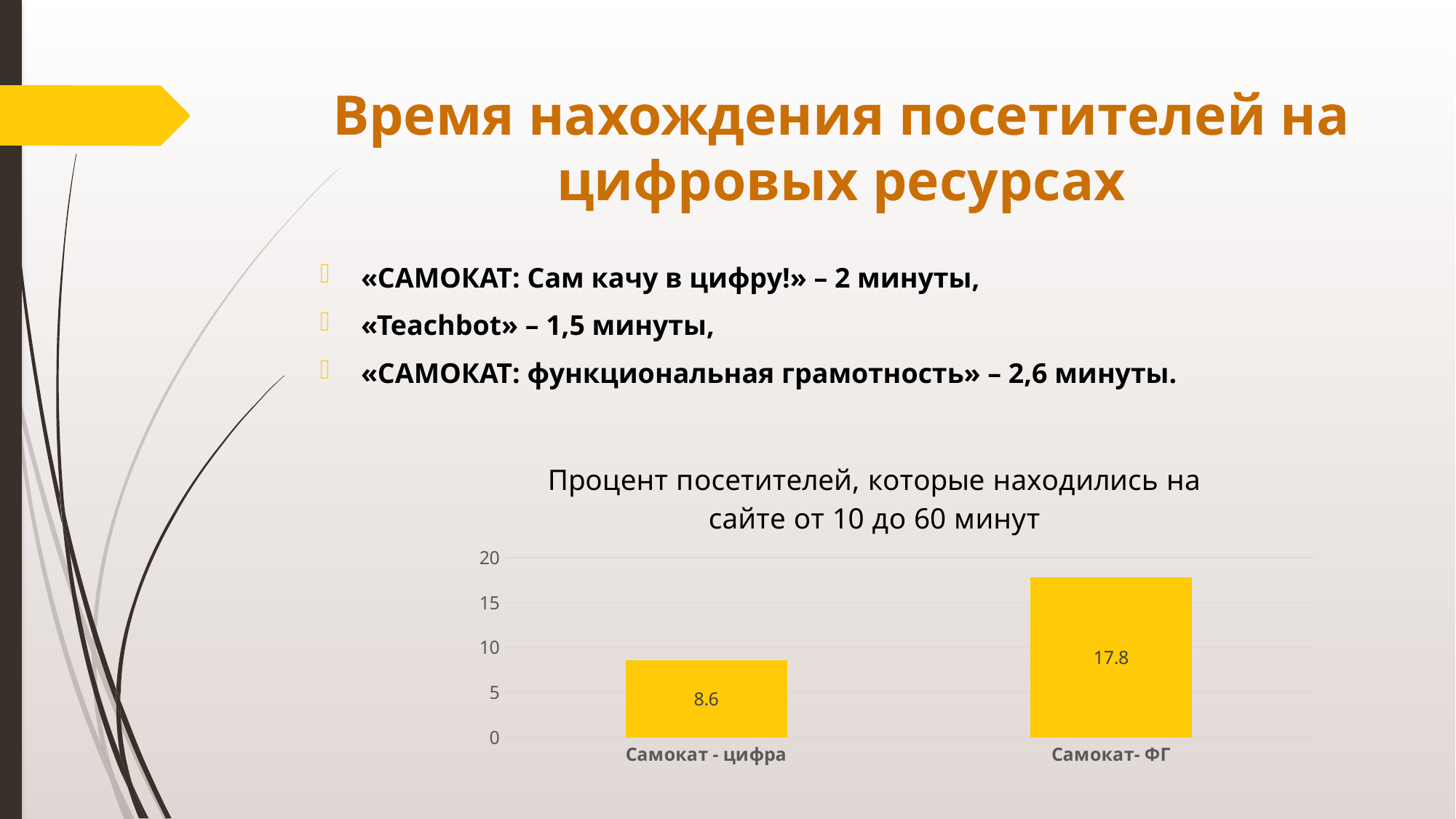
Which is larger, the value for Самокат - цифра or the value for Самокат- ФГ? Самокат- ФГ What is the difference between the values for Самокат- ФГ and Самокат - цифра? 9.2 What is the title of the chart? Процент посетителей, которые находились на сайте от 10 до 60 минут Is the value for Самокат- ФГ greater or less than 15? greater Which category has the highest value? Самокат- ФГ How many categories are shown in the chart? 2 What is the value for Самокат- ФГ? 17.8 Which category has the lowest value? Самокат - цифра Is the value for Самокат - цифра greater or less than 10? less What kind of chart is shown on the slide? bar chart What is the highest value shown on the vertical axis of the chart? 20 What is the value for Самокат - цифра? 8.6